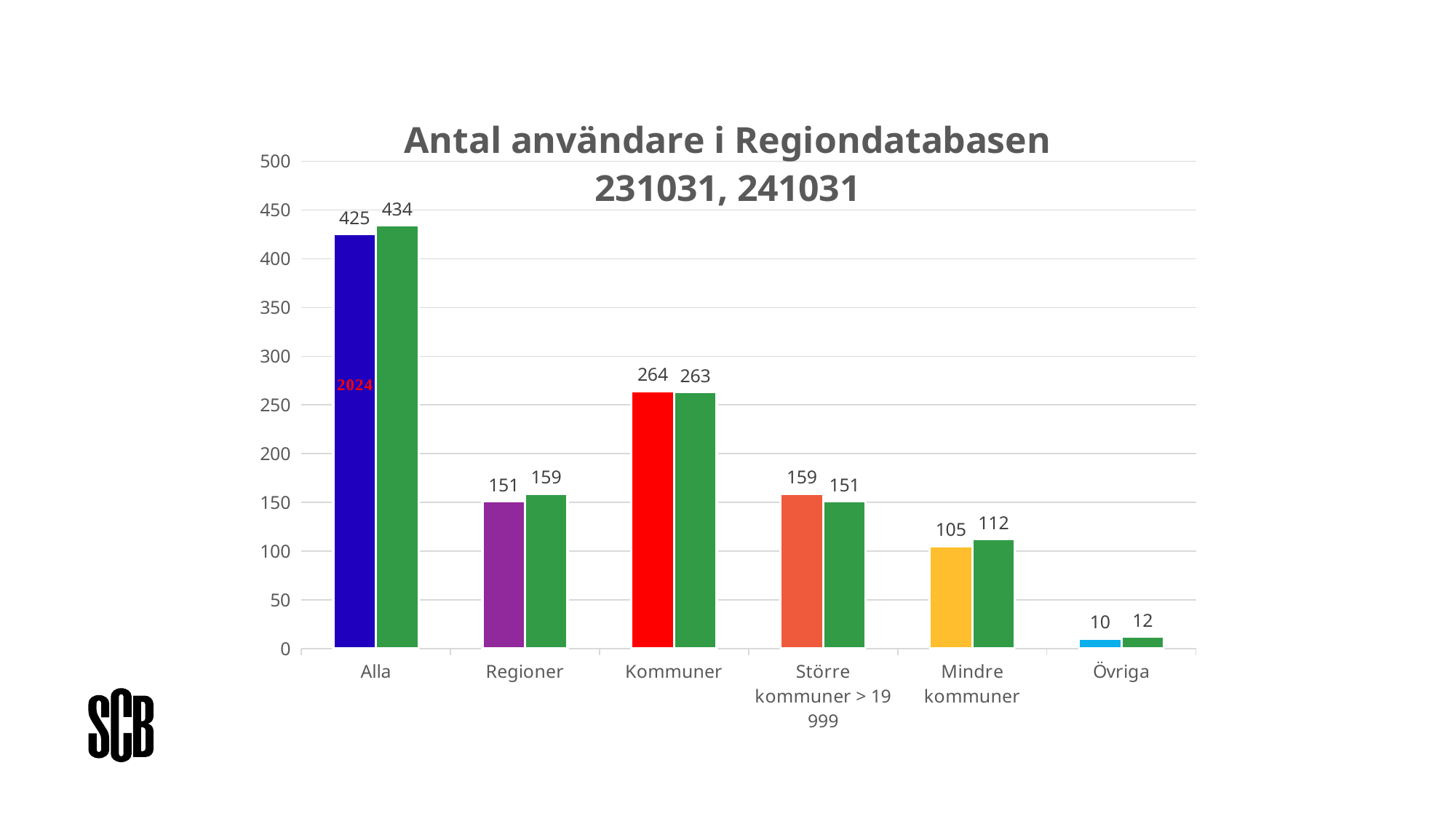
For Större kommuner > 19 999, which bar is larger, the first (orange) bar or the green bar? the first (orange) bar What is the value of the green bar for Alla? 434 What is the value of the green bar for Mindre kommuner? 112 What is the difference between the two bars for Alla (434 and 425)? 9 How many categories are shown on the x axis? 6 What is the title of the chart? Antal användare i Regiondatabasen 231031, 241031 What type of chart is shown on the slide? bar chart What is the value of the first (blue) bar for Alla? 425 Which category has the highest values? Alla Which category has the lowest values? Övriga What is the value of the first (red) bar for Kommuner? 264 What is the value of the green bar for Regioner? 159